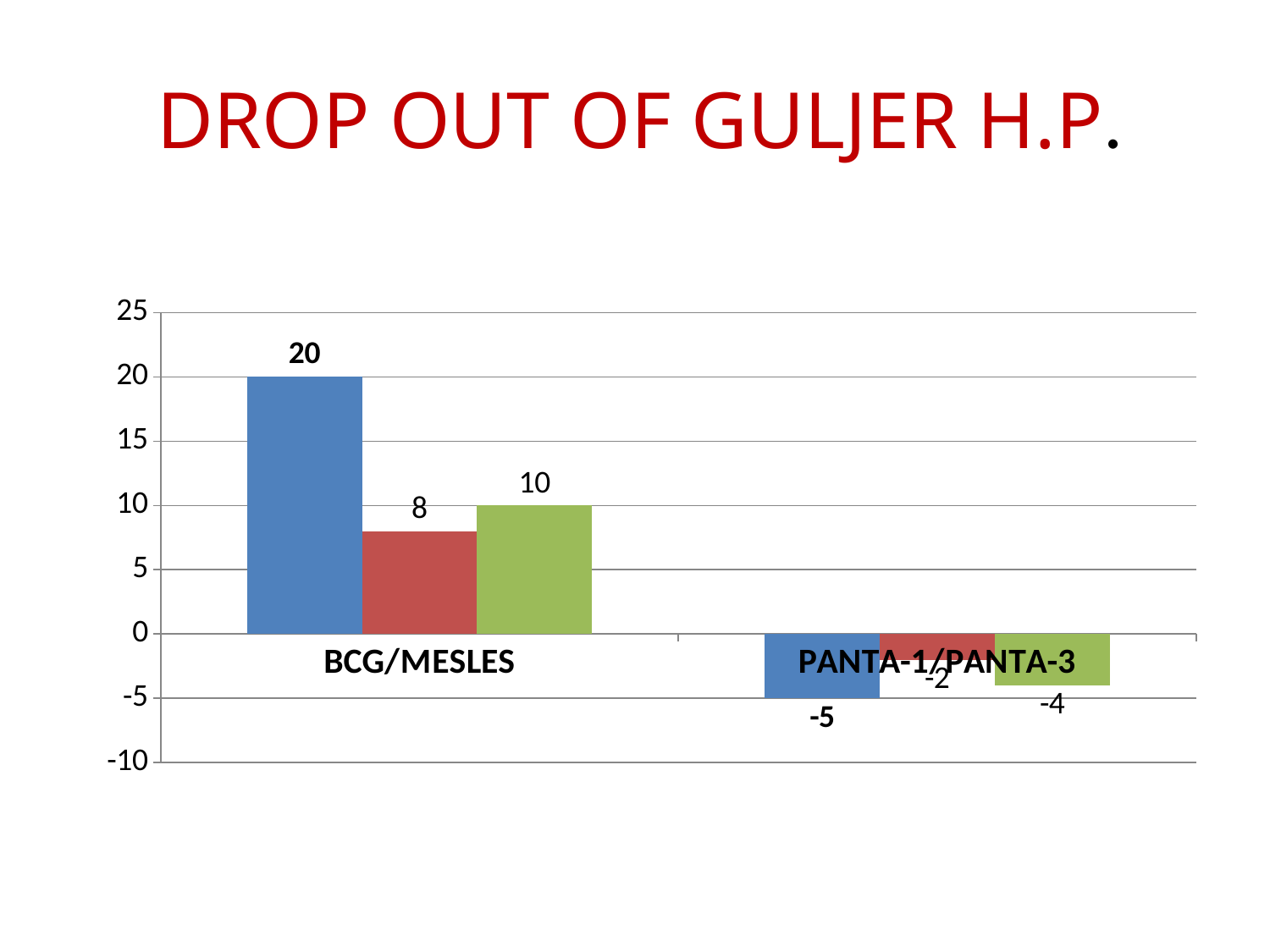
How many categories are shown on the x axis? 2 What type of chart is shown on the slide? Bar chart What is the value of the green bar for PANTA-1/PANTA-3? -4 What is the value of the red bar for BCG/MESLES? 8 What is the value of the blue bar for PANTA-1/PANTA-3? -5 Which bar has the highest value on the chart? The blue bar for BCG/MESLES (20) Which bar has the lowest value on the chart? The blue bar for PANTA-1/PANTA-3 (-5) What is the value of the blue bar for BCG/MESLES? 20 What is the value of the green bar for BCG/MESLES? 10 What is the difference between the blue bar and the red bar for BCG/MESLES? 12 What is the value of the red bar for PANTA-1/PANTA-3? -2 Which is larger for BCG/MESLES, the red bar or the green bar? The green bar